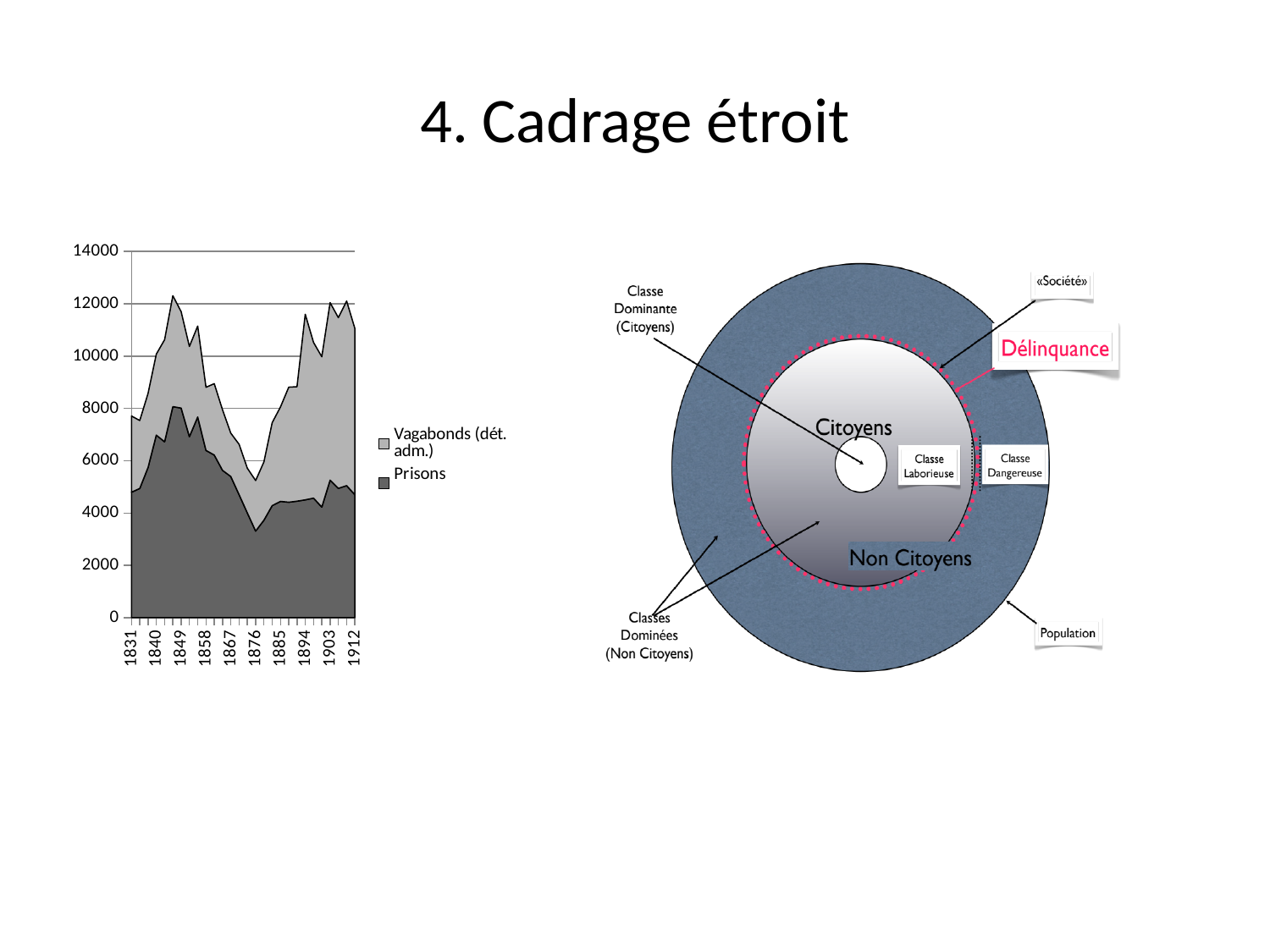
In the left chart, is the Prisons value in 1876 greater or less than 4000? less What kind of chart is shown on the left of the slide? Stacked area chart What is the last year labelled on the x axis of the left chart? 1912 What is the highest value shown on the y axis of the left chart? 14000 In the left chart, is the combined total of both series in 1876 greater or less than 6000? less What is the first year labelled on the x axis of the left chart? 1831 In the left chart, does the Prisons series rise or fall between 1876 and 1912? rise How many series does the legend of the left chart list? 2 What are the two series named in the legend of the left chart? Vagabonds (dét. adm.) and Prisons Which series in the left chart is drawn in the darker grey? Prisons In the left chart, is the Prisons value in 1831 greater or less than 6000? less How many year labels are shown on the x axis of the left chart? 10